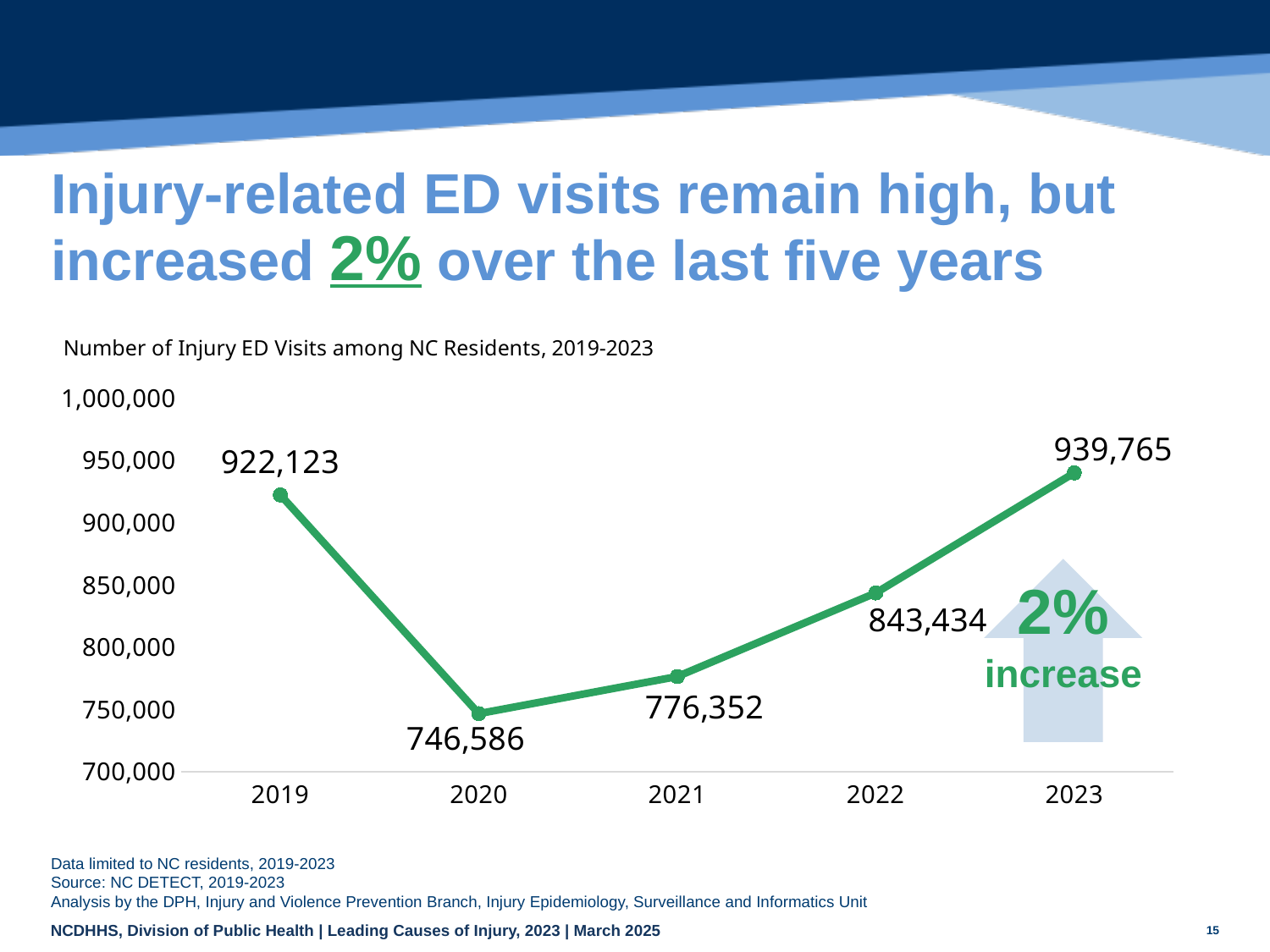
Which year has the lowest number of injury ED visits? 2020 What is the number of injury ED visits in 2022? 843,434 What is the number of injury ED visits in 2020? 746,586 Which year had more injury ED visits, 2021 or 2022? 2022 How many years are plotted on the chart? 5 Do the values rise or fall from 2020 to 2023? rise What is the number of injury ED visits in 2019? 922,123 Which year has the highest number of injury ED visits? 2023 What is the difference in injury ED visits between 2019 and 2020? 175,537 What kind of chart is shown on the slide? line chart Is the value for 2021 greater or less than 800,000? less What is the difference in injury ED visits between 2023 and 2019? 17,642